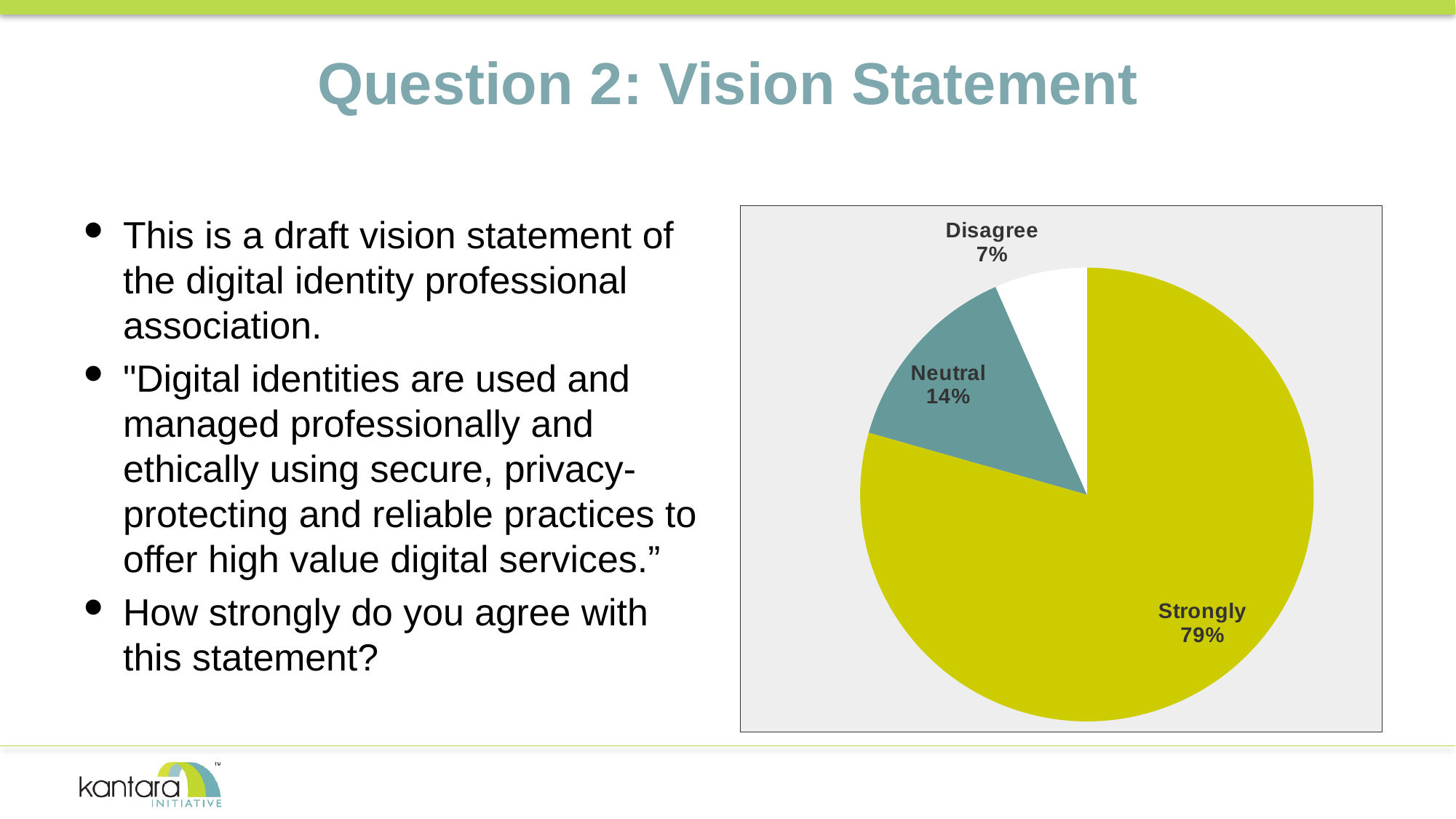
What share of the pie is labelled Strongly? 79% What kind of chart is shown on the slide? pie chart What is the difference in percentage points between the Strongly and Neutral slices? 65 Which slice of the pie is the smallest? Disagree How many slices does the pie chart have? 3 Which slice of the pie is the largest? Strongly What share of the pie is labelled Neutral? 14% Which slice is larger, Neutral or Disagree? Neutral What share of the pie is labelled Disagree? 7% What colour is the Strongly slice of the pie? yellow-green What colour is the Neutral slice of the pie? teal What is the difference in percentage points between the Neutral and Disagree slices? 7